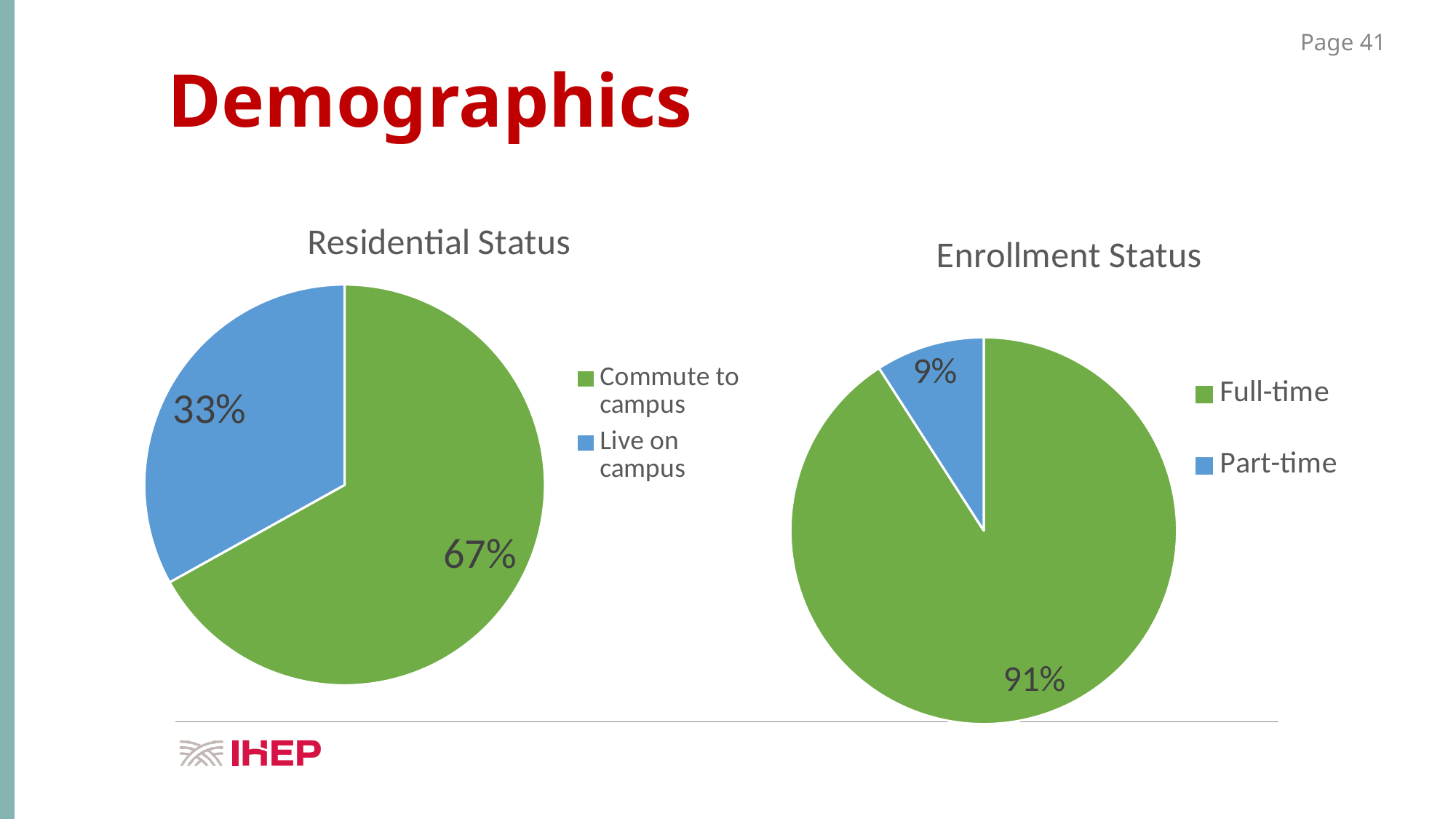
In the Residential Status chart, what percentage of students live on campus? 33% In the Enrollment Status chart, which category has the smallest share? Part-time In the Residential Status chart, which category has the largest share? Commute to campus In the Residential Status chart, what percentage of students commute to campus? 67% In the Enrollment Status chart, what is the difference in percentage points between full-time and part-time students? 82 In the Enrollment Status chart, what percentage of students are part-time? 9% In the Enrollment Status chart, what colour is the Part-time slice? blue How many categories does the Residential Status chart show? 2 Is the share of students who live on campus in the Residential Status chart larger or smaller than the share of part-time students in the Enrollment Status chart? larger In the Enrollment Status chart, what percentage of students are full-time? 91% In the Residential Status chart, what is the difference in percentage points between students who commute to campus and those who live on campus? 34 What type of chart is the Enrollment Status chart? pie chart